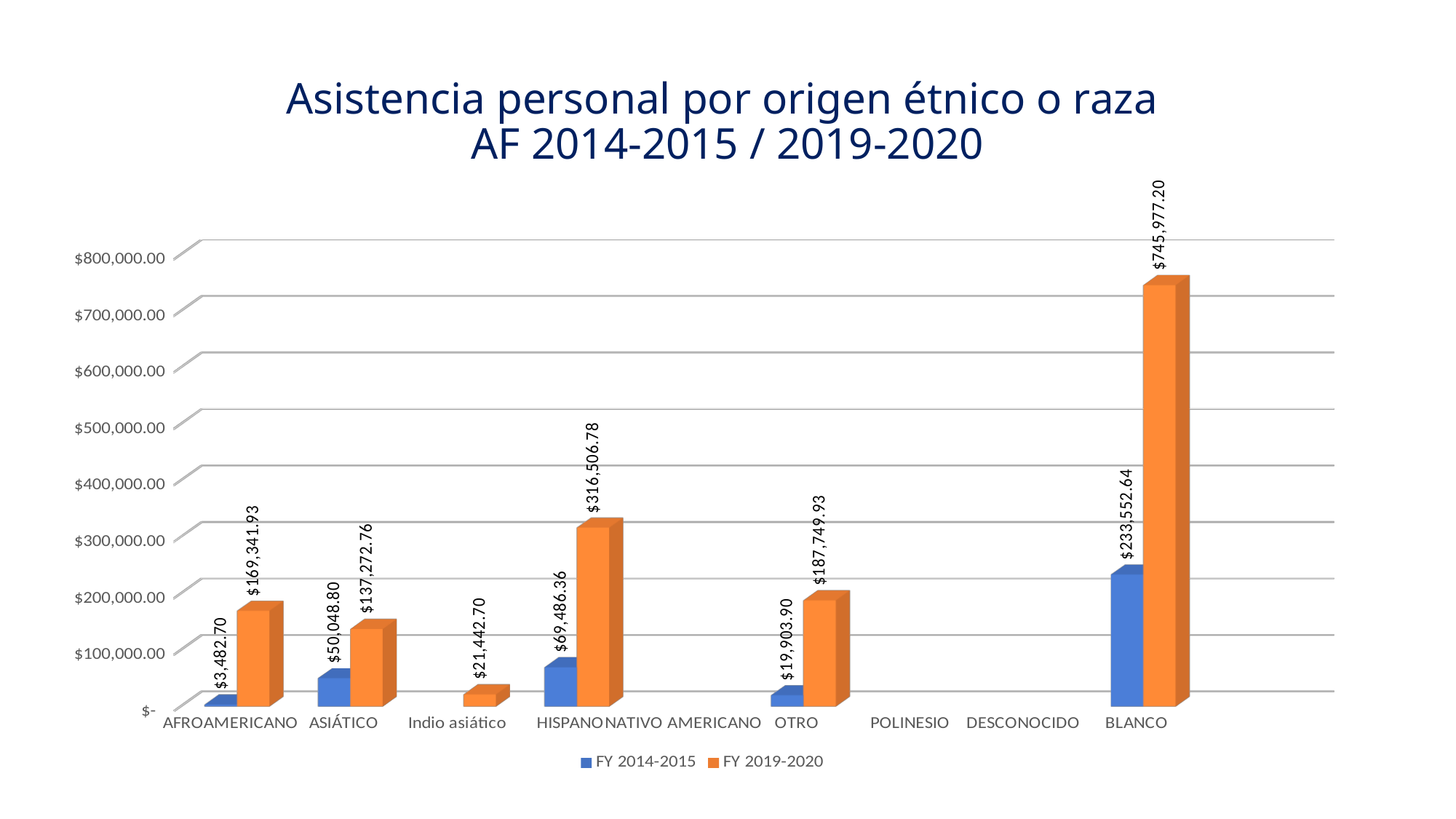
How many series does the legend list? 2 How many categories are shown on the x axis? 9 Which category has the highest FY 2019-2020 value? BLANCO What type of chart is shown on the slide? Bar chart What is the FY 2014-2015 value for AFROAMERICANO? $3,482.70 What is the FY 2019-2020 value for BLANCO? $745,977.20 What is the difference between the FY 2019-2020 and FY 2014-2015 values for BLANCO? $512,424.56 Which category has the lowest FY 2014-2015 value among those with a labeled FY 2014-2015 bar? AFROAMERICANO What is the FY 2019-2020 value for Indio asiático? $21,442.70 Is the FY 2019-2020 value for HISPANO greater or less than $300,000.00? greater Which is larger, the FY 2019-2020 value for OTRO or the FY 2019-2020 value for ASIÁTICO? OTRO What is the FY 2014-2015 value for HISPANO? $69,486.36